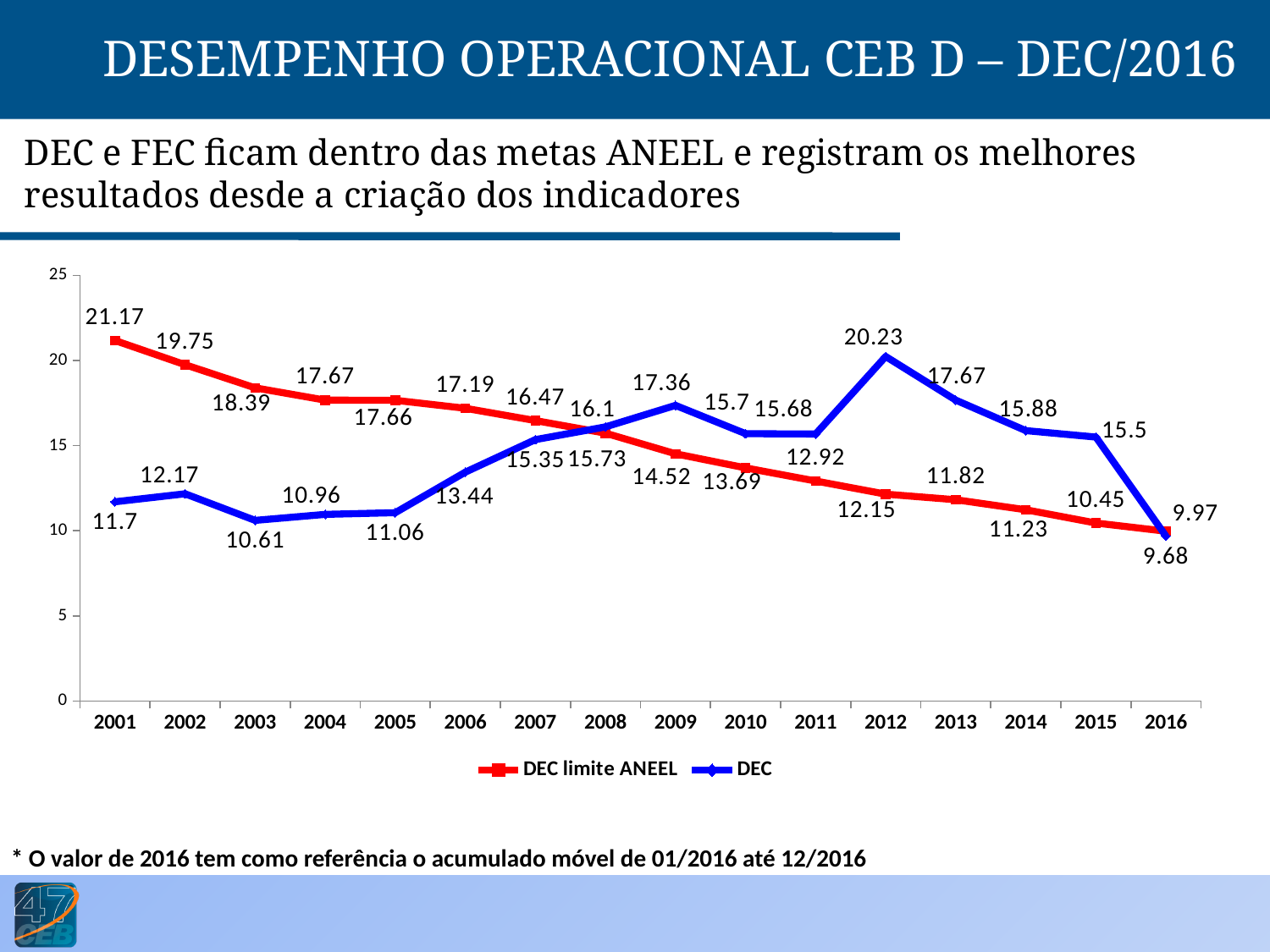
In which year does the DEC series reach its lowest value? 2016 In which year does the DEC series reach its highest value? 2012 How many series does the legend list? 2 What kind of chart is shown on the slide? Line chart By how much did the DEC series fall from 2012 to 2013? 2.56 What is the value of the DEC series in 2006? 13.44 How many years are plotted on the x axis? 16 What is the value of the DEC limite ANEEL series in 2001? 21.17 In 2009, which series has the larger value, DEC or DEC limite ANEEL? DEC What is the difference between DEC limite ANEEL and DEC in 2016? 0.29 Does the DEC limite ANEEL series rise or fall from 2001 to 2016? Fall What is the value of the DEC series in 2012? 20.23